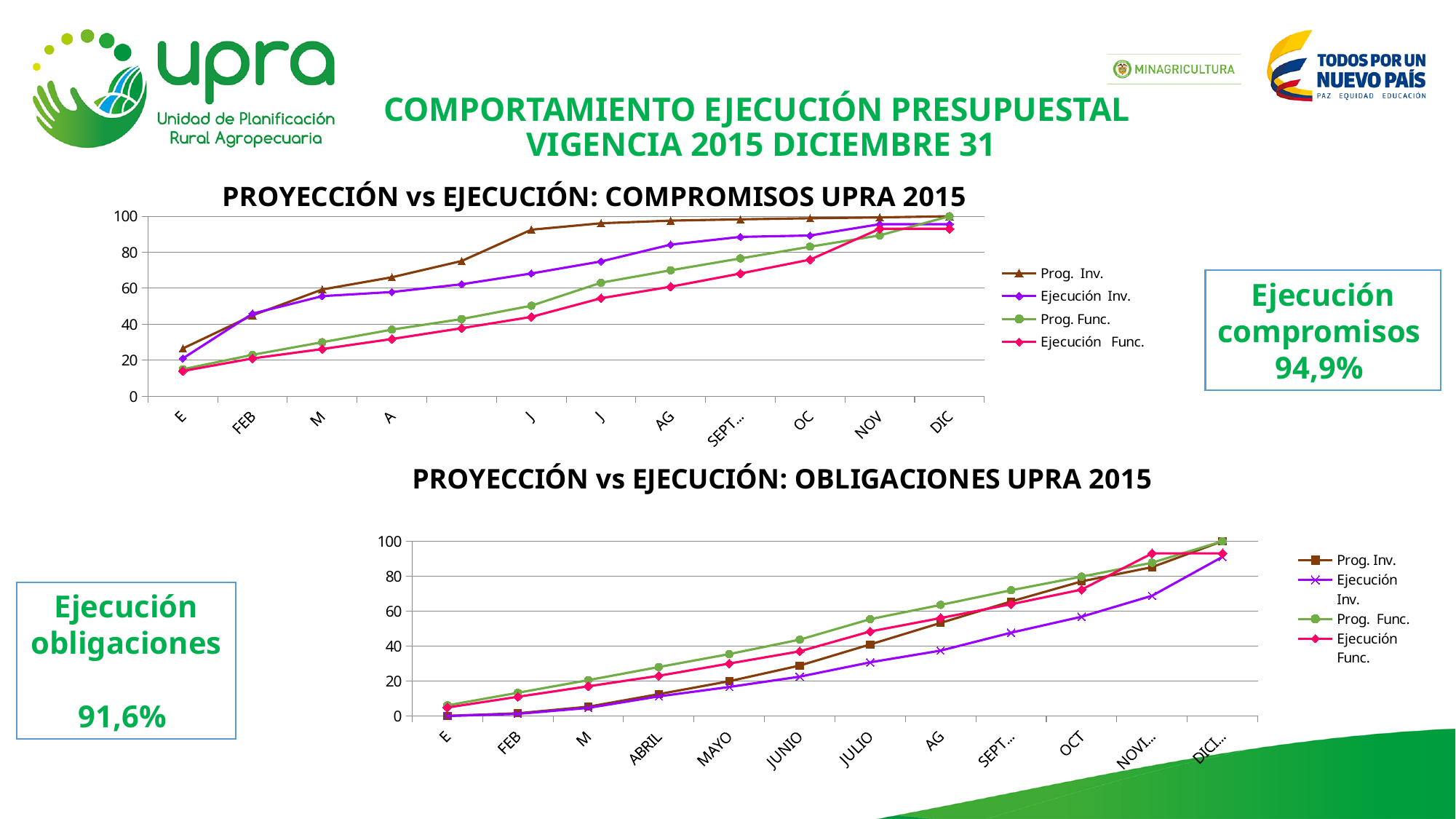
In the 'PROYECCIÓN vs EJECUCIÓN: COMPROMISOS UPRA 2015' chart, is the value of Ejecución Func. at E greater or less than 20? less In the 'PROYECCIÓN vs EJECUCIÓN: OBLIGACIONES UPRA 2015' chart, is the value of Ejecución Inv. at OCT greater or less than 60? less In the 'PROYECCIÓN vs EJECUCIÓN: OBLIGACIONES UPRA 2015' chart, do the Ejecución Inv. values rise or fall from E to DICI...? Rise What is the title of the upper chart on the slide? PROYECCIÓN vs EJECUCIÓN: COMPROMISOS UPRA 2015 In the 'PROYECCIÓN vs EJECUCIÓN: OBLIGACIONES UPRA 2015' chart, is the value of Prog. Func. at JUNIO greater or less than 40? greater How many series does the legend of the 'PROYECCIÓN vs EJECUCIÓN: OBLIGACIONES UPRA 2015' chart list? 4 In the 'PROYECCIÓN vs EJECUCIÓN: OBLIGACIONES UPRA 2015' chart, which is larger at JULIO: Prog. Func. or Ejecución Inv.? Prog. Func. In the 'PROYECCIÓN vs EJECUCIÓN: COMPROMISOS UPRA 2015' chart, which is larger at OC: Prog. Inv. or Ejecución Func.? Prog. Inv. In the 'PROYECCIÓN vs EJECUCIÓN: COMPROMISOS UPRA 2015' chart, which series is drawn in brown with triangle markers? Prog. Inv. What type of chart is 'PROYECCIÓN vs EJECUCIÓN: COMPROMISOS UPRA 2015'? Line chart How many points are plotted along the x axis of the 'PROYECCIÓN vs EJECUCIÓN: COMPROMISOS UPRA 2015' chart? 12